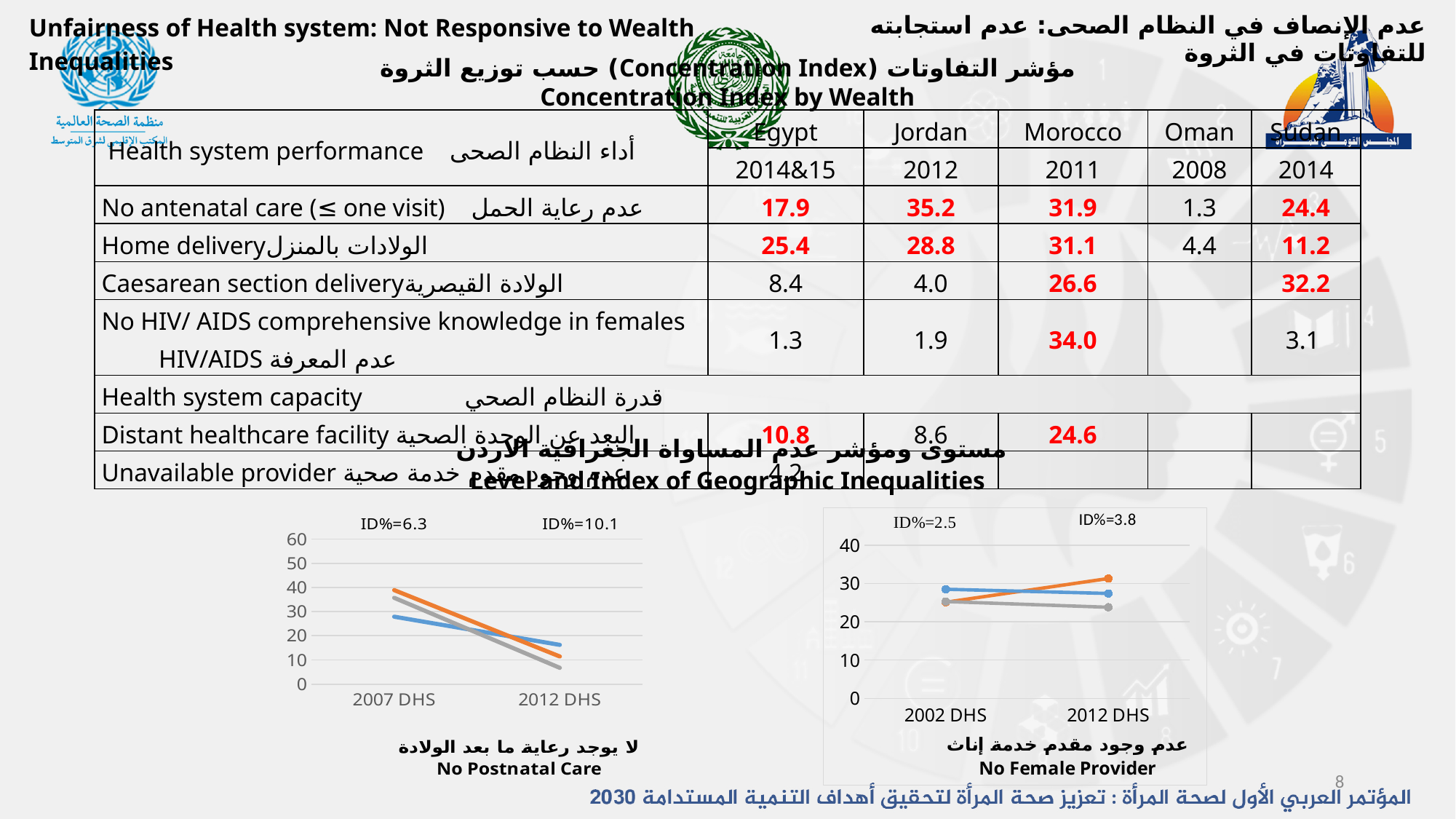
In the 'No Female Provider' chart, does the orange line rise or fall from 2002 DHS to 2012 DHS? rise In the 'No Postnatal Care' chart, is the value of the blue line at 2012 DHS greater or less than 10? greater In the 'No Female Provider' chart, is the value of the orange line at 2002 DHS greater or less than 20? greater In the 'No Postnatal Care' chart, how many points are shown on the x axis? 2 What kind of chart is the 'No Female Provider' chart at the bottom right of the slide? line chart In the 'No Postnatal Care' chart, is the value of the gray line at 2012 DHS greater or less than 10? less What ID% value is shown above the 2002 DHS point in the 'No Female Provider' chart? ID%=2.5 What kind of chart is the 'No Postnatal Care' chart at the bottom left of the slide? line chart In the 'No Female Provider' chart, how many lines are plotted? 3 In the 'No Postnatal Care' chart, do the lines rise or fall from 2007 DHS to 2012 DHS? fall What ID% value is shown above the 2012 DHS point in the 'No Postnatal Care' chart? ID%=10.1